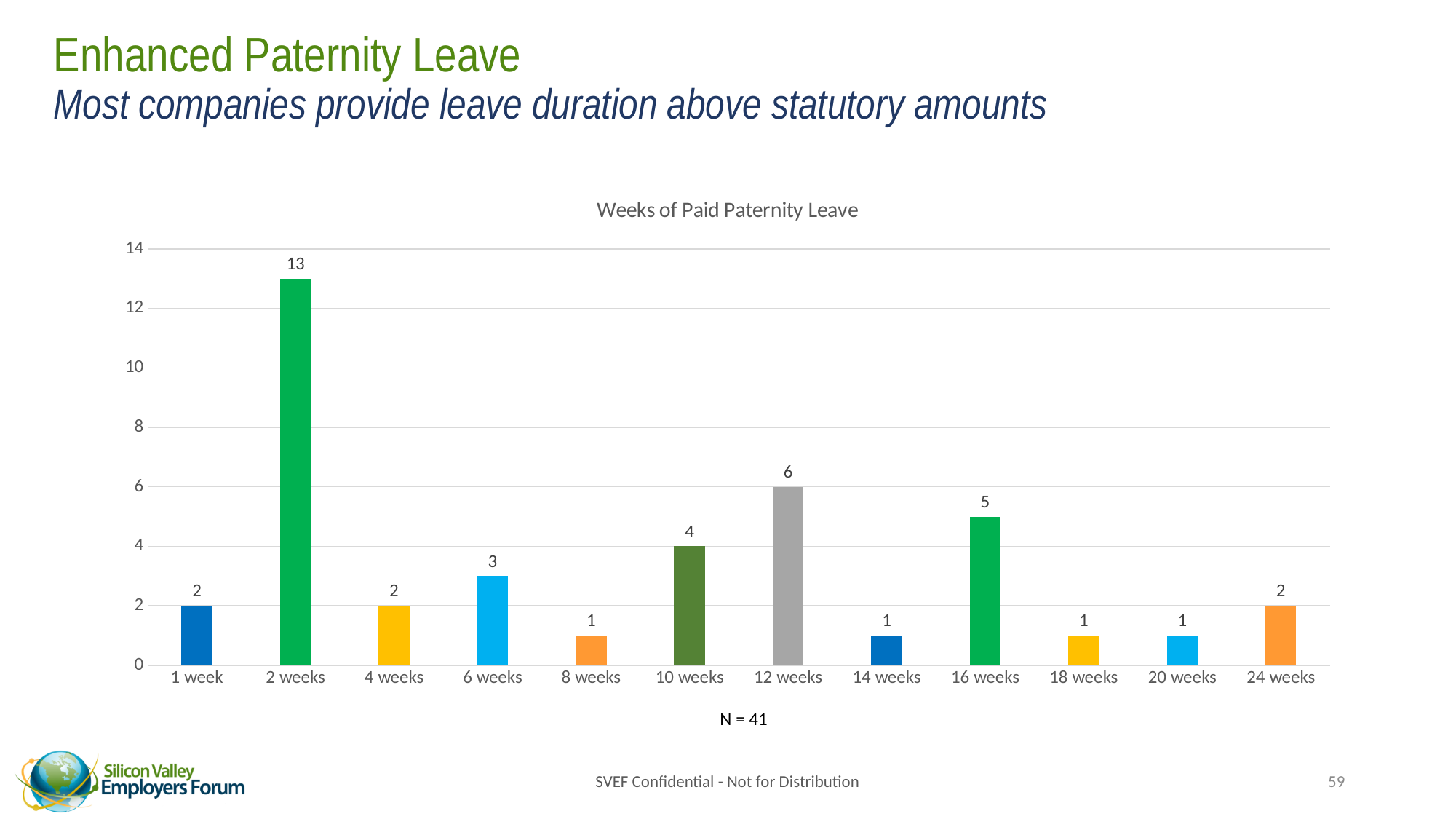
What is the value for 16 weeks? 5 Which is larger, the value for 16 weeks or the value for 10 weeks? 16 weeks What is the value for 2 weeks? 13 What is the title of the chart? Weeks of Paid Paternity Leave What is the difference between the values for 10 weeks and 6 weeks? 1 How many categories are shown on the x axis? 12 Which category has the highest value? 2 weeks What sample size (N) is shown below the chart? N = 41 What kind of chart is shown? bar chart What is the value for 12 weeks? 6 Is the value for 2 weeks greater or less than 12? greater What is the difference between the values for 2 weeks and 12 weeks? 7